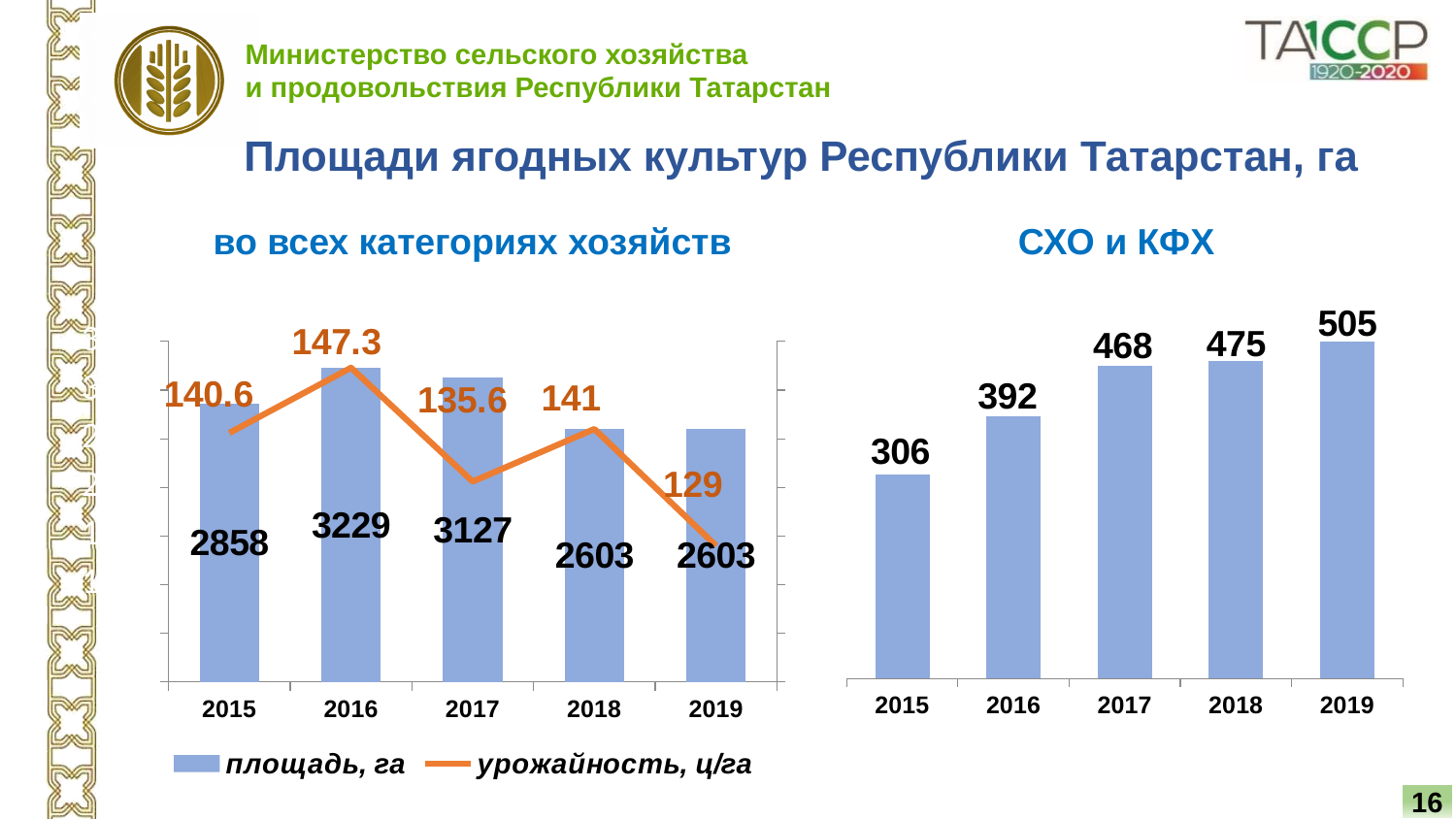
In the chart 'СХО и КФХ', what is the value for 2017? 468 In the chart 'во всех категориях хозяйств', is 'площадь, га' larger in 2015 or in 2018? 2015 In the chart 'СХО и КФХ', what is the difference between the values for 2019 and 2015? 199 In the chart 'во всех категориях хозяйств', what is the difference in 'площадь, га' between 2016 and 2017? 102 In the chart 'СХО и КФХ', which year has the lowest value? 2015 In the chart 'во всех категориях хозяйств', how many series does the legend list? 2 In the chart 'СХО и КФХ', do the values rise or fall from 2015 to 2019? rise In the chart 'во всех категориях хозяйств', what is the value of 'площадь, га' for 2016? 3229 In the chart 'во всех категориях хозяйств', which year has the lowest 'урожайность, ц/га'? 2019 In the chart 'во всех категориях хозяйств', which year has the highest 'урожайность, ц/га'? 2016 What kind of chart is 'СХО и КФХ'? bar chart In the chart 'во всех категориях хозяйств', what is the value of 'урожайность, ц/га' for 2017? 135.6